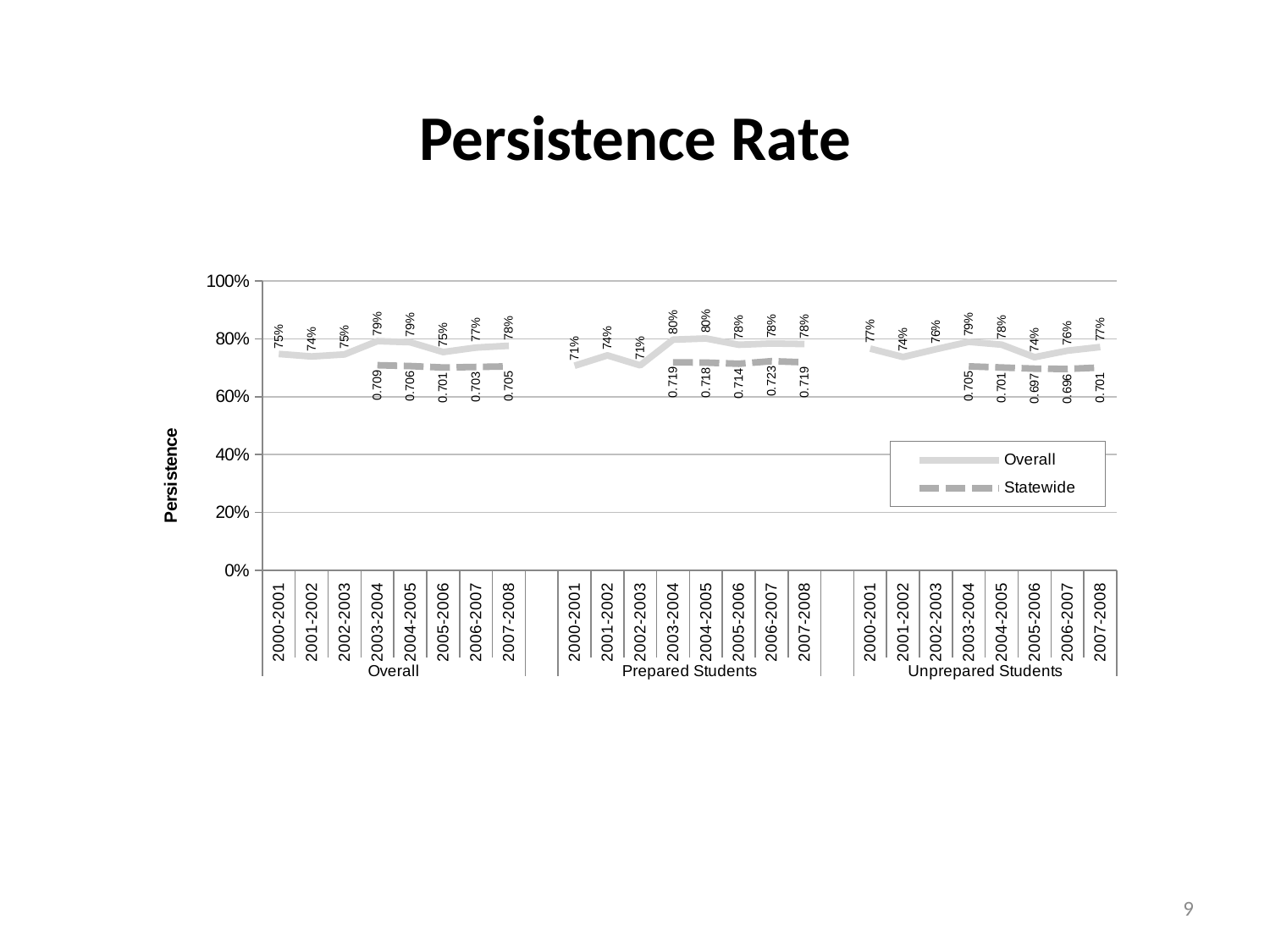
What is the Statewide value for Unprepared Students in 2006-2007? 0.696 What is the Statewide value for the Overall group in 2007-2008? 0.705 How many year categories are shown within each student group? 8 Which year has the lowest Overall persistence rate among Prepared Students? 2000-2001 and 2002-2003 (71%) What is the Overall persistence rate for Prepared Students in 2003-2004? 80% Which year has the highest Overall persistence rate among Unprepared Students? 2003-2004 How many series does the legend list? 2 What is the label on the vertical axis? Persistence What is the difference between the Overall persistence rate for Prepared Students in 2003-2004 and in 2000-2001? 9% Is the Overall persistence rate for Prepared Students in 2004-2005 higher or lower than for Unprepared Students in 2004-2005? higher What is the Overall persistence rate in the Overall group for 2005-2006? 75% What kind of chart is shown on the slide? line chart